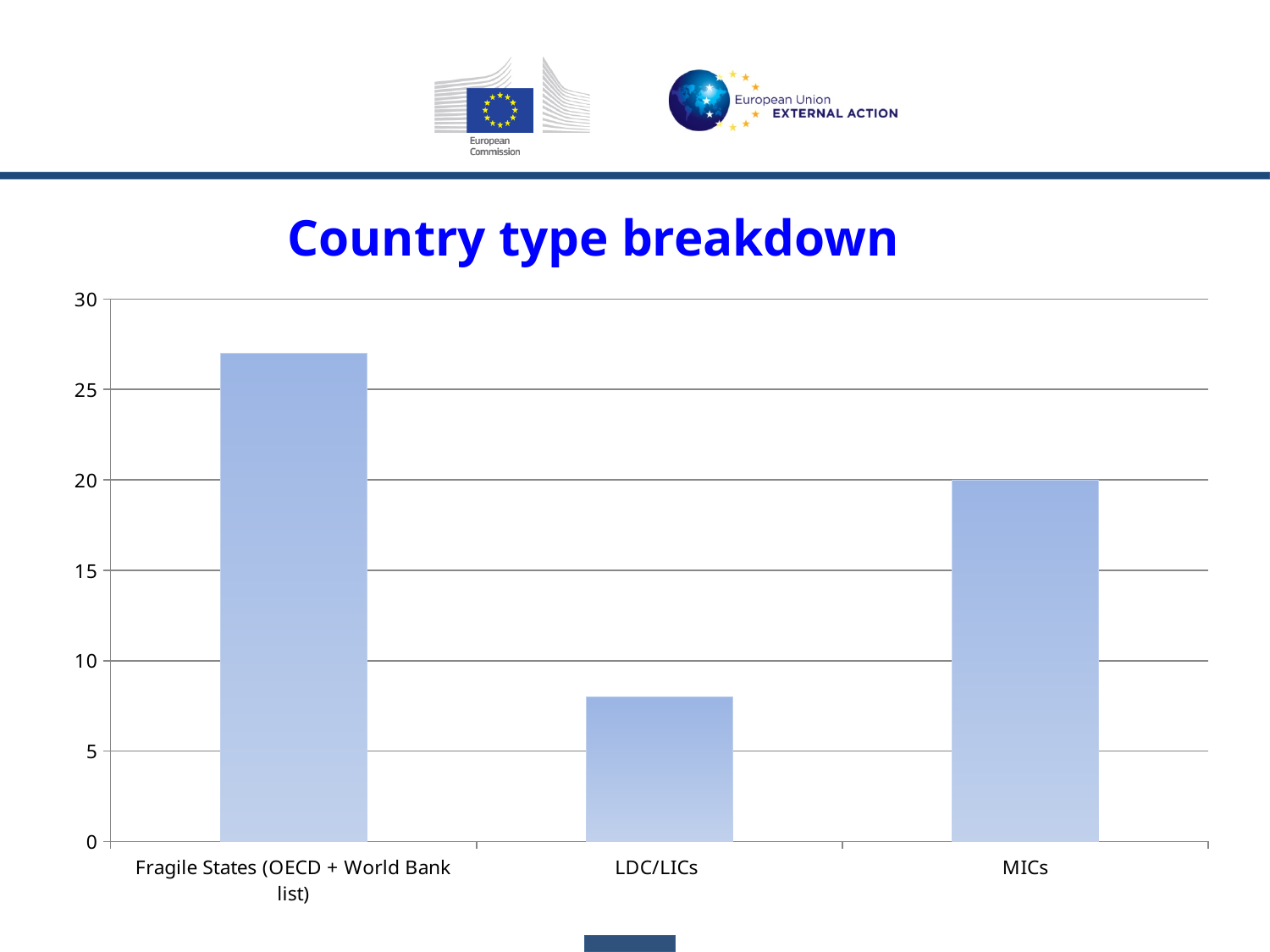
What is the value for MICs? 20 Is the value for LDC/LICs greater or less than 10? less Which category has the lowest value in the chart? LDC/LICs Which is larger, the value for Fragile States (OECD + World Bank list) or the value for MICs? Fragile States (OECD + World Bank list) Which is larger, the value for MICs or the value for LDC/LICs? MICs What is the maximum value shown on the y axis of the chart? 30 Which category has the highest value in the chart? Fragile States (OECD + World Bank list) What is the title of the chart? Country type breakdown Is the value for Fragile States (OECD + World Bank list) greater or less than 30? less How many categories are shown on the x axis of the chart? 3 Is the value for Fragile States (OECD + World Bank list) greater or less than 25? greater What kind of chart is shown on the slide? bar chart